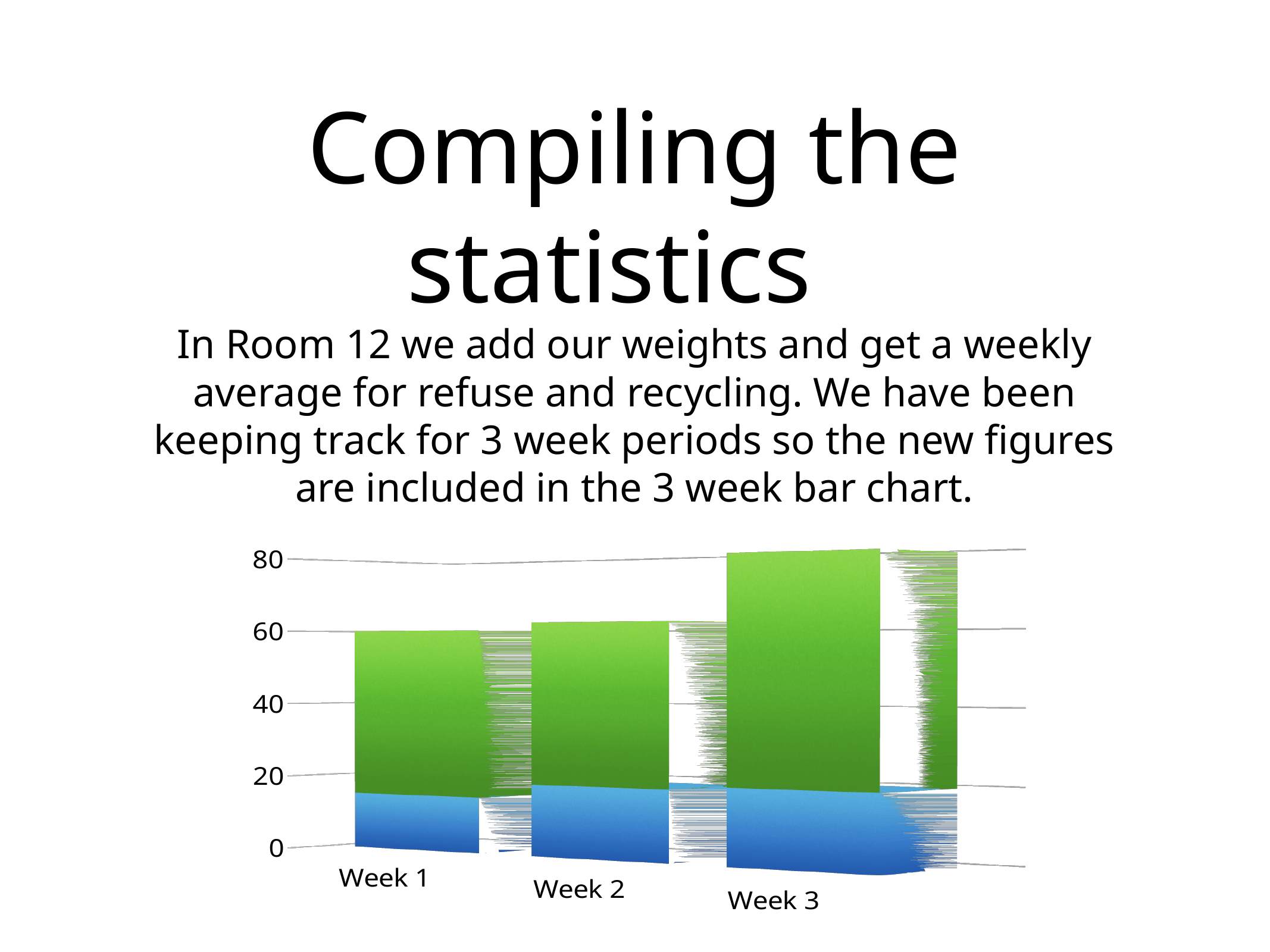
Is the total bar height for Week 2 greater or less than 80? less Which bar is taller, Week 3 or Week 1? Week 3 What is the highest value labelled on the vertical axis of the chart? 80 Is the blue segment of the Week 1 bar greater or less than 20? less What kind of chart is shown on the slide? bar chart Is the total bar height for Week 3 greater or less than 60? greater Do the bar heights rise or fall from Week 1 to Week 3? rise How many weeks are shown on the x axis of the chart? 3 Which week has the tallest bar in the chart? Week 3 Which week has the shortest bar in the chart? Week 1 What two colours are used for the segments of each bar in the chart? blue and green